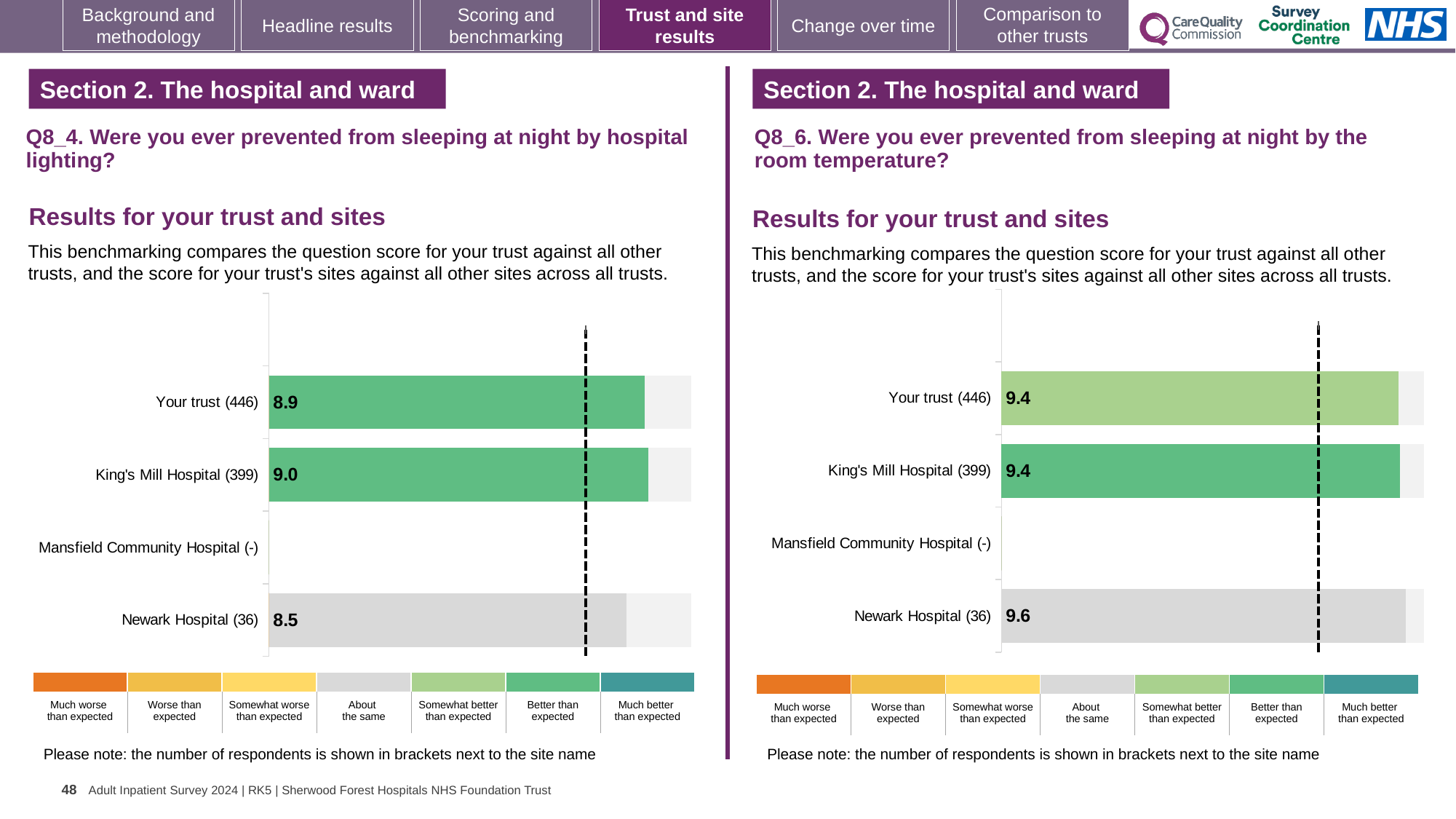
In the Q8_6 chart (room temperature), what is the difference between the scores for Newark Hospital and Your trust? 0.2 In the Q8_6 chart (room temperature), what is the score for Your trust? 9.4 In the Q8_4 chart (hospital lighting), what is the difference between the scores for King's Mill Hospital and Newark Hospital? 0.5 In the Q8_4 chart (hospital lighting), what is the score for King's Mill Hospital? 9.0 What kind of chart is used in the Q8_4 chart (hospital lighting)? bar chart How many respondents are shown in brackets for Newark Hospital in the Q8_4 chart? 36 In the Q8_6 chart (room temperature), which site has the highest score? Newark Hospital In the Q8_4 chart (hospital lighting), which site has the highest score? King's Mill Hospital In the Q8_4 chart (hospital lighting), what is the score for Newark Hospital? 8.5 In the Q8_4 chart (hospital lighting), what is the score for Your trust? 8.9 In the Q8_6 chart (room temperature), is the score for Newark Hospital larger or smaller than the score for King's Mill Hospital? larger In the Q8_6 chart (room temperature), what is the score for Newark Hospital? 9.6